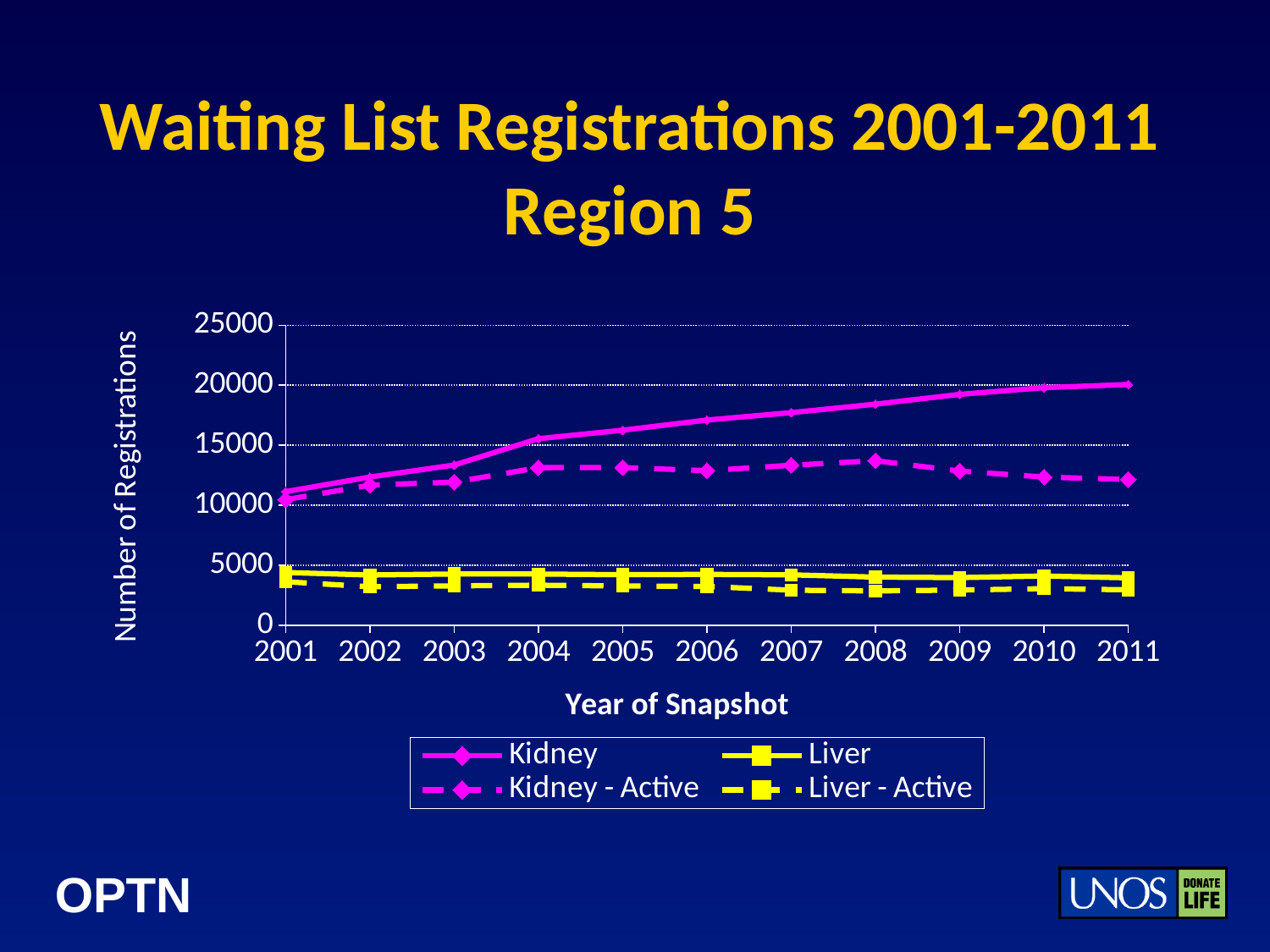
How many years are plotted along the x axis? 11 Is the Liver value for 2001 greater or less than 5000? less In which year is the Kidney series at its lowest? 2001 What is the title of the x axis? Year of Snapshot How many series does the legend list? 4 In which year is the Kidney series at its highest? 2011 In 2011, which is larger: Kidney or Liver? Kidney Does the Kidney series rise or fall from 2001 to 2011? rise Is the Kidney value for 2001 greater or less than 10000? greater Is the Kidney - Active value for 2008 greater or less than 15000? less What kind of chart is shown on the slide? line chart